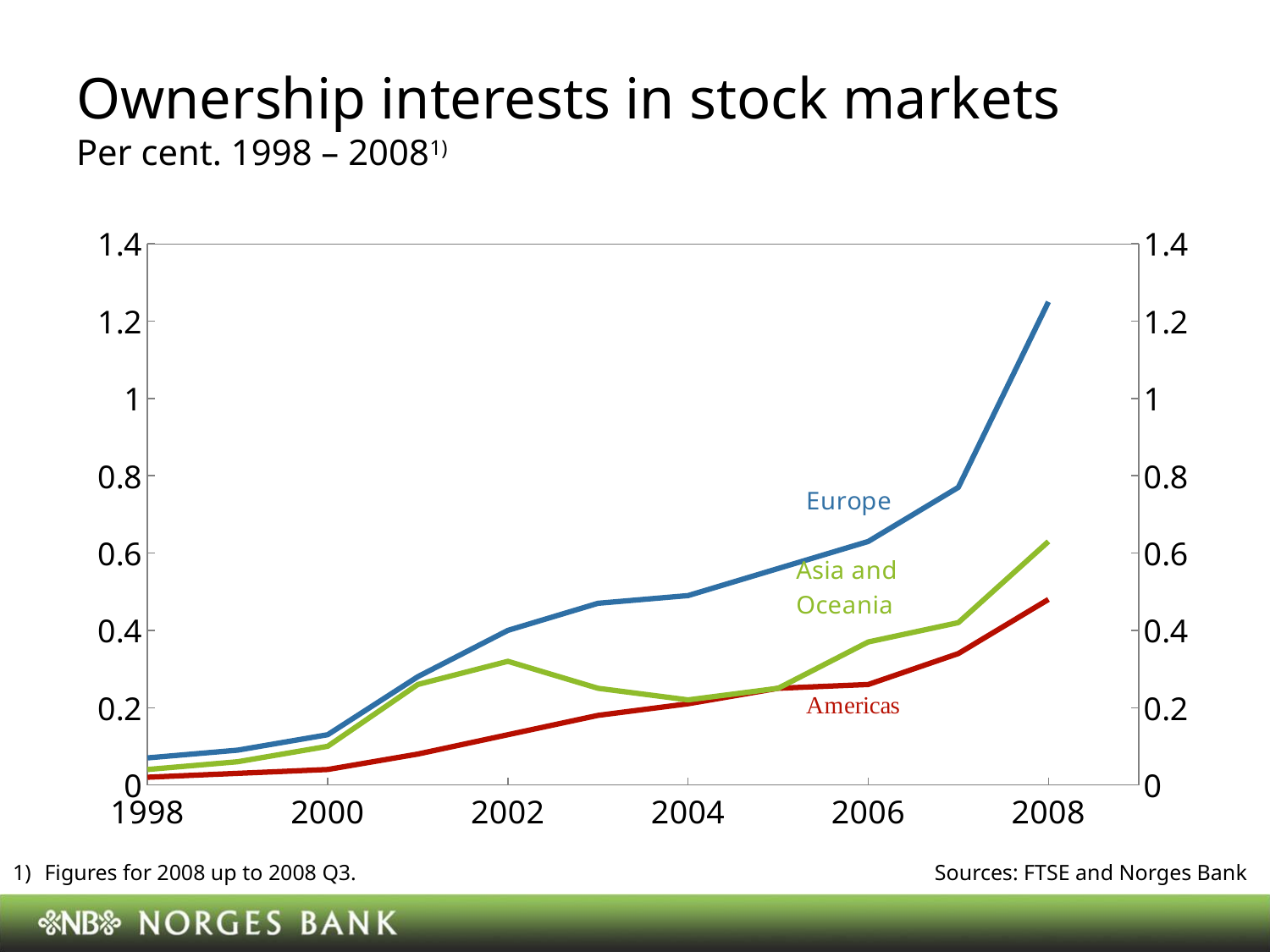
Which series has the lowest value in 2008? Americas What kind of chart is shown on the slide? line chart What colour is the Europe line? blue Does the Europe line rise or fall from 1998 to 2008? rise Is the value for Americas in 2002 greater or less than 0.2? less Which series has the highest value in 2008? Europe Is the value for Americas in 2008 greater or less than 0.6? less Is the value for Europe in 2008 greater or less than 1? greater In 2006, which is larger: the value for Asia and Oceania or the value for Americas? Asia and Oceania How many series are plotted on the chart? 3 In 2004, which is larger: the value for Europe or the value for Americas? Europe